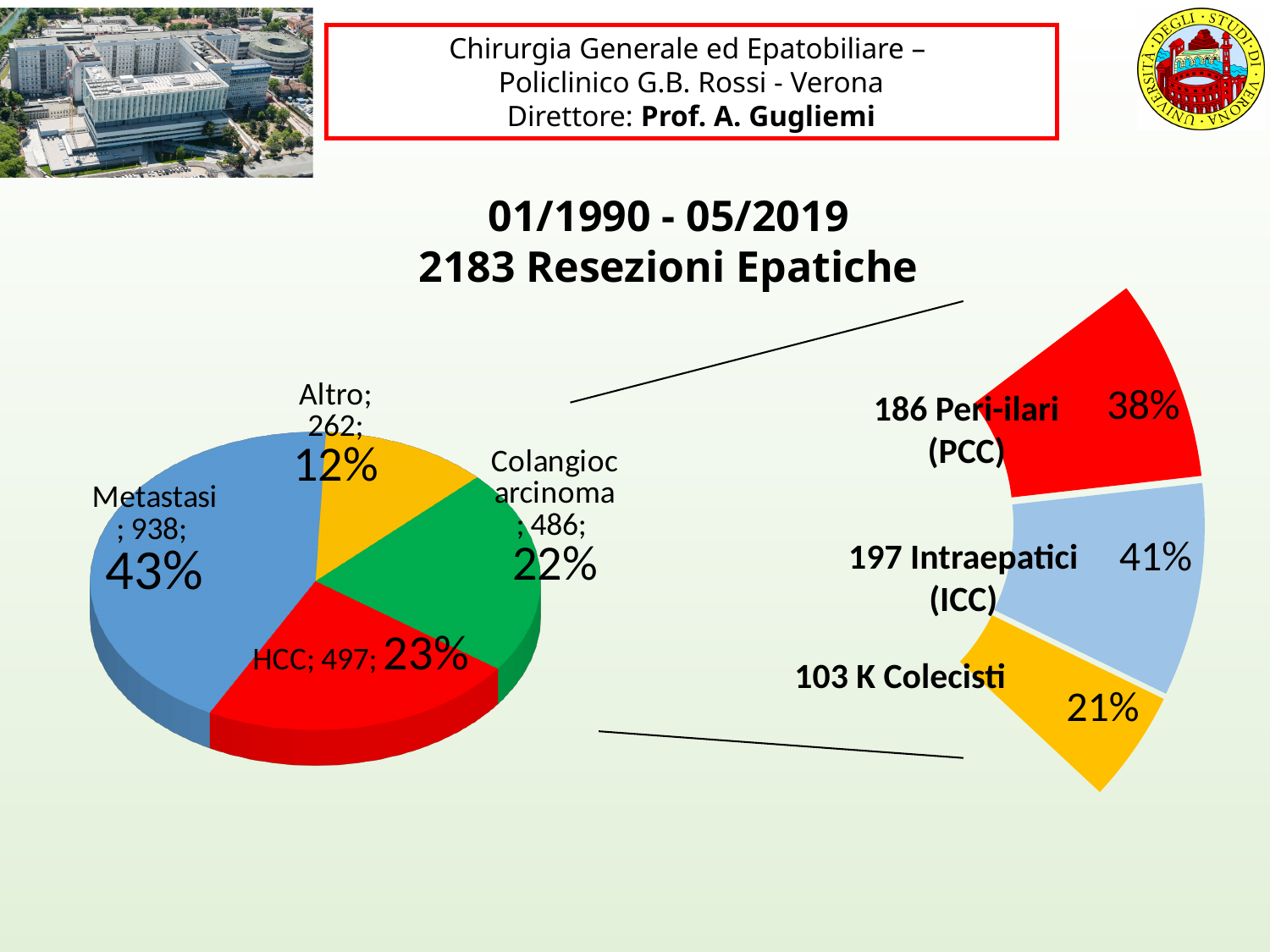
In the pie chart on the left, how many resections are labelled for Metastasi? 938 What kind of chart is shown on the left of the slide? pie chart In the pie chart on the left, which category has the smallest slice? Altro In the breakdown on the right, what percentage is shown for Intraepatici (ICC)? 41% In the pie chart on the left, which category has the largest slice? Metastasi In the pie chart on the left, what percentage is shown for HCC? 23% In the breakdown on the right, how many cases are labelled for K Colecisti? 103 In the pie chart on the left, how many categories are shown? 4 In the pie chart on the left, what value is shown for Colangiocarcinoma? 486 In the pie chart on the left, what percentage is shown for Altro? 12% In the breakdown on the right, which is larger: Peri-ilari (PCC) or Intraepatici (ICC)? Intraepatici (ICC) In the pie chart on the left, what is the difference between the Metastasi count and the HCC count? 441